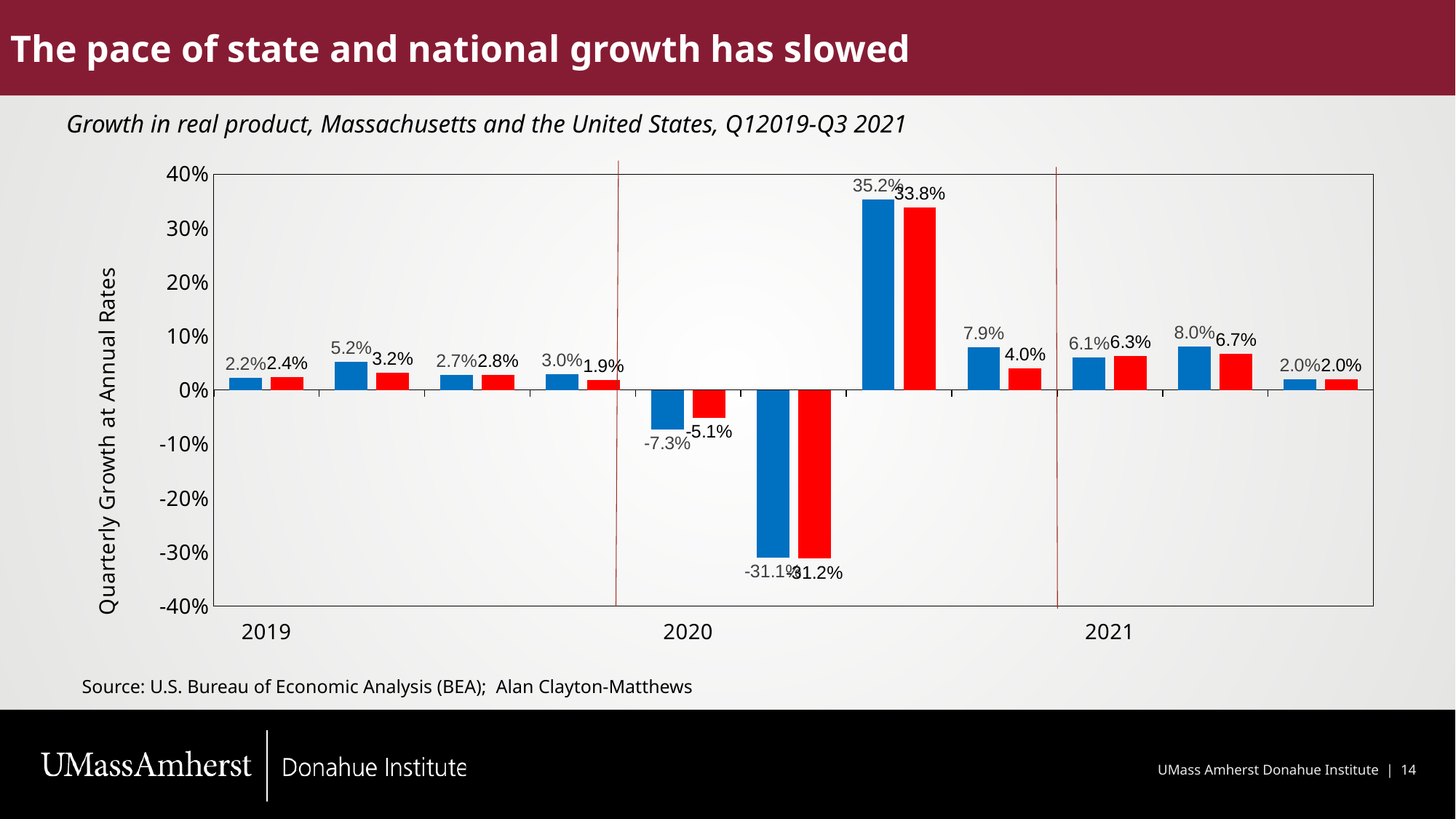
What is the value of the red bar in the third quarter of 2020? 33.8% What is the lowest value shown for a red bar in the chart? -31.2% In which year does the chart show the highest growth rate? 2020 What is the difference between the blue bar (35.2%) and the red bar (33.8%) in the third quarter of 2020? 1.4 percentage points In the second quarter of 2019, which bar is larger, the blue bar or the red bar? The blue bar (5.2%) What is the value of the tallest blue bar in the chart? 35.2% What is the value of the red bar in the fourth quarter of 2020? 4.0% How many quarters (pairs of bars) are plotted in the chart? 11 What is the title of the vertical axis? Quarterly Growth at Annual Rates What is the value of the blue bar in the first quarter of 2020? -7.3% What is the value of the red bar in the last quarter shown (Q3 2021)? 2.0% What kind of chart is shown on the slide? Bar chart